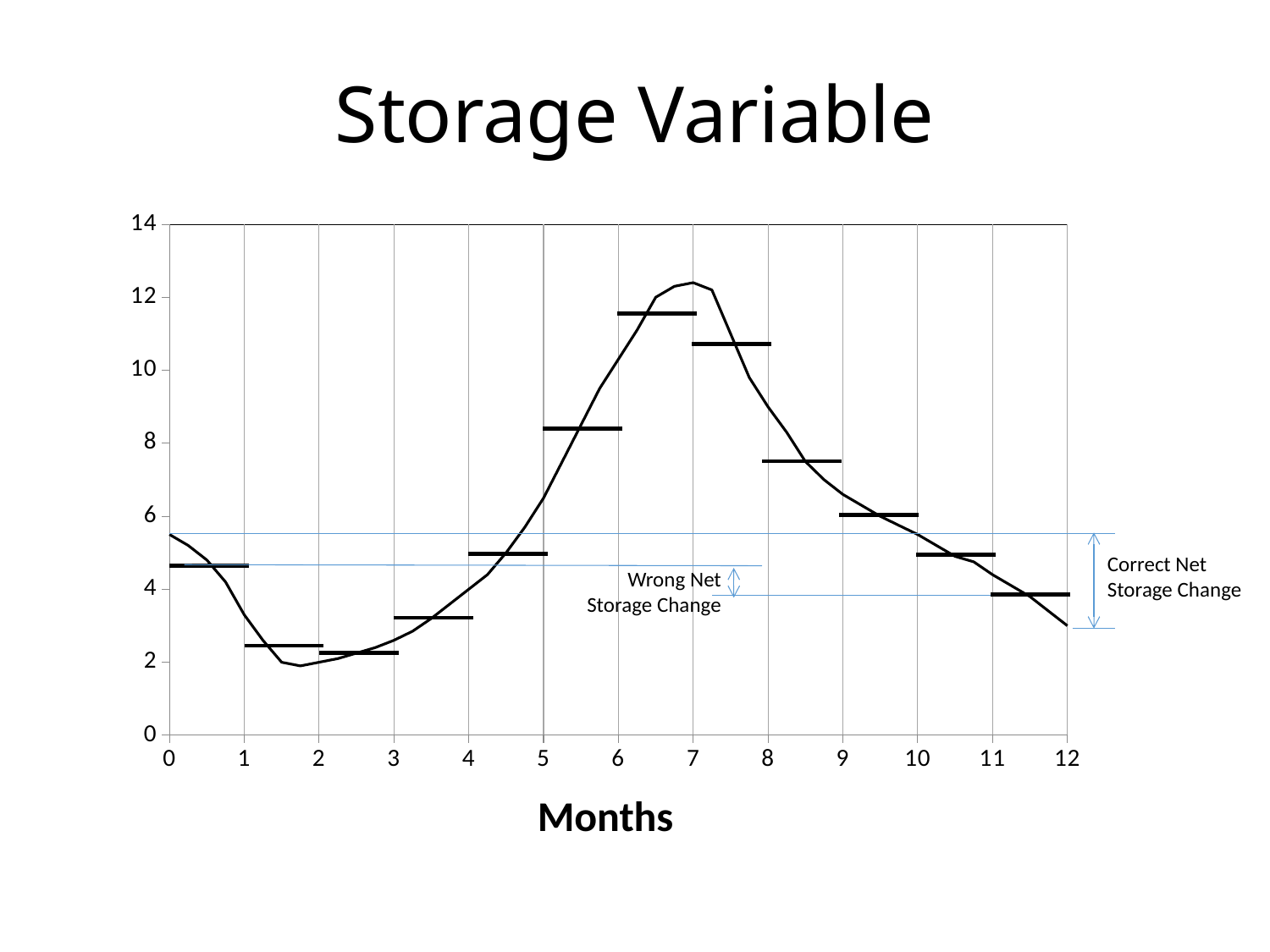
At which labelled month does the curve reach its highest value? 7 Is the value of the curve at month 7 greater or less than 10? greater Is the value of the curve at month 0 greater or less than 4? greater Is the value of the curve at month 2 greater or less than 4? less What is the highest value shown on the y axis? 14 Does the curve rise or fall between month 2 and month 7? rise What kind of chart is shown on the slide? line chart Does the curve rise or fall between month 7 and month 12? fall What is the title of the chart's x axis? Months What are the two net storage change annotations labelled on the chart? Wrong Net Storage Change and Correct Net Storage Change